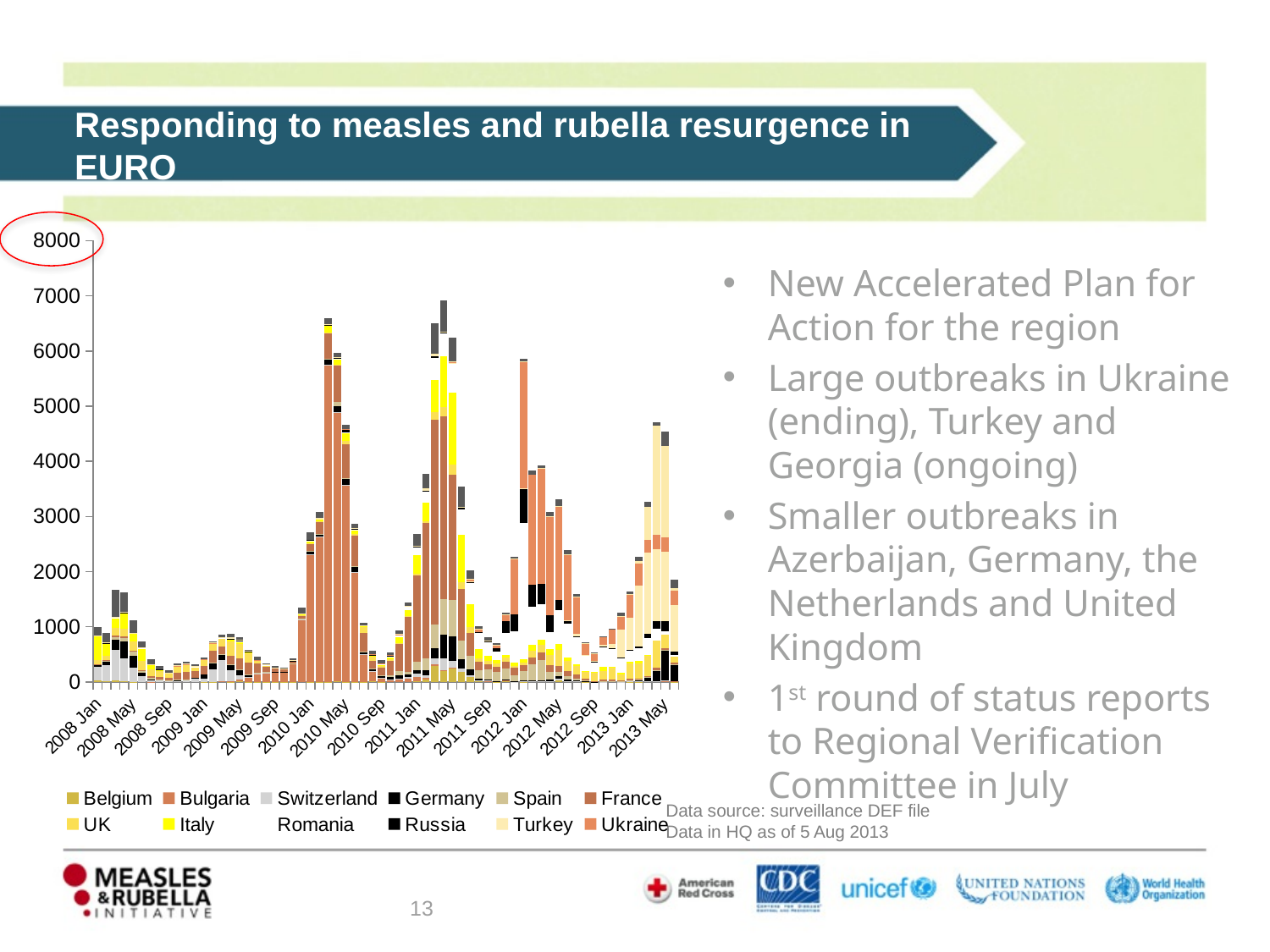
Is the value of the bar at 2013 May greater or less than 4000? greater Is the value of the bar at 2012 Jan greater or less than 5000? greater Is the value of the tallest bar in the chart greater or less than 6000? greater Do the bar totals rise or fall from 2010 May to 2010 Sep? fall How many countries does the chart legend list? 12 Which bar is taller, the one at 2012 Jan or the one at 2012 Sep? 2012 Jan What is the highest value shown on the chart's vertical axis? 8000 What kind of chart is shown on the slide? stacked bar chart Which colour represents Ukraine in the chart legend? orange Which bar is taller, the one at 2010 May or the one at 2009 May? 2010 May Do the bar totals rise or fall from 2012 Sep to 2013 May? rise